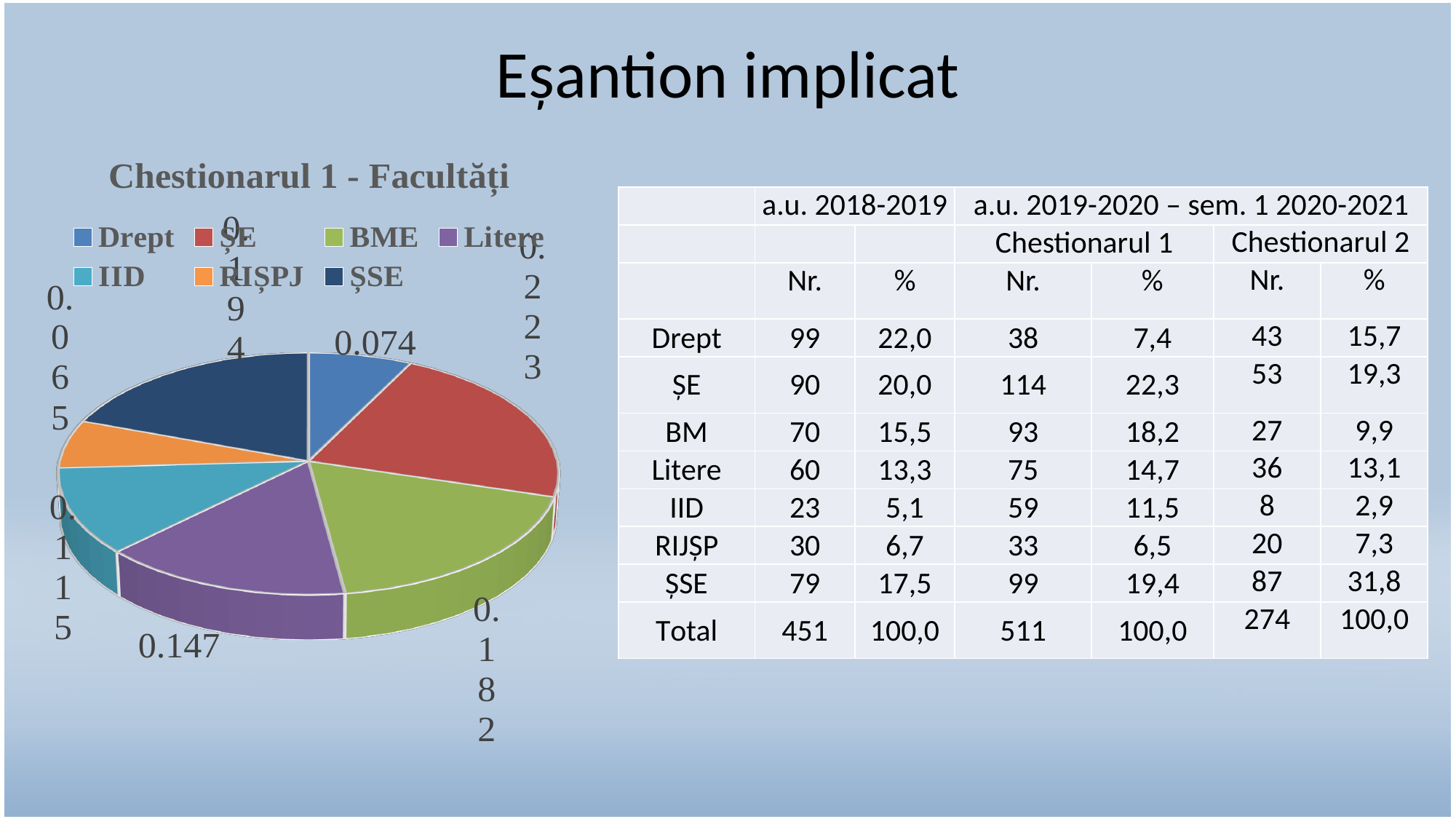
What kind of chart is shown on the slide? pie chart What is the value shown for Litere in the pie chart? 0.147 Which category has the largest slice in the pie chart? ȘE What is the title of the chart? Chestionarul 1 - Facultăți Which slice is larger in the pie chart, ȘE or BME? ȘE What is the value shown for Drept in the pie chart? 0.074 Which colour represents ȘSE in the pie chart? dark blue How many slices does the pie chart have? 7 Which category has the smallest slice in the pie chart? RIȘPJ How many entries does the chart legend list? 7 What is the difference between the values for ȘE and BME in the pie chart? 0.041 What is the value shown for BME in the pie chart? 0.182